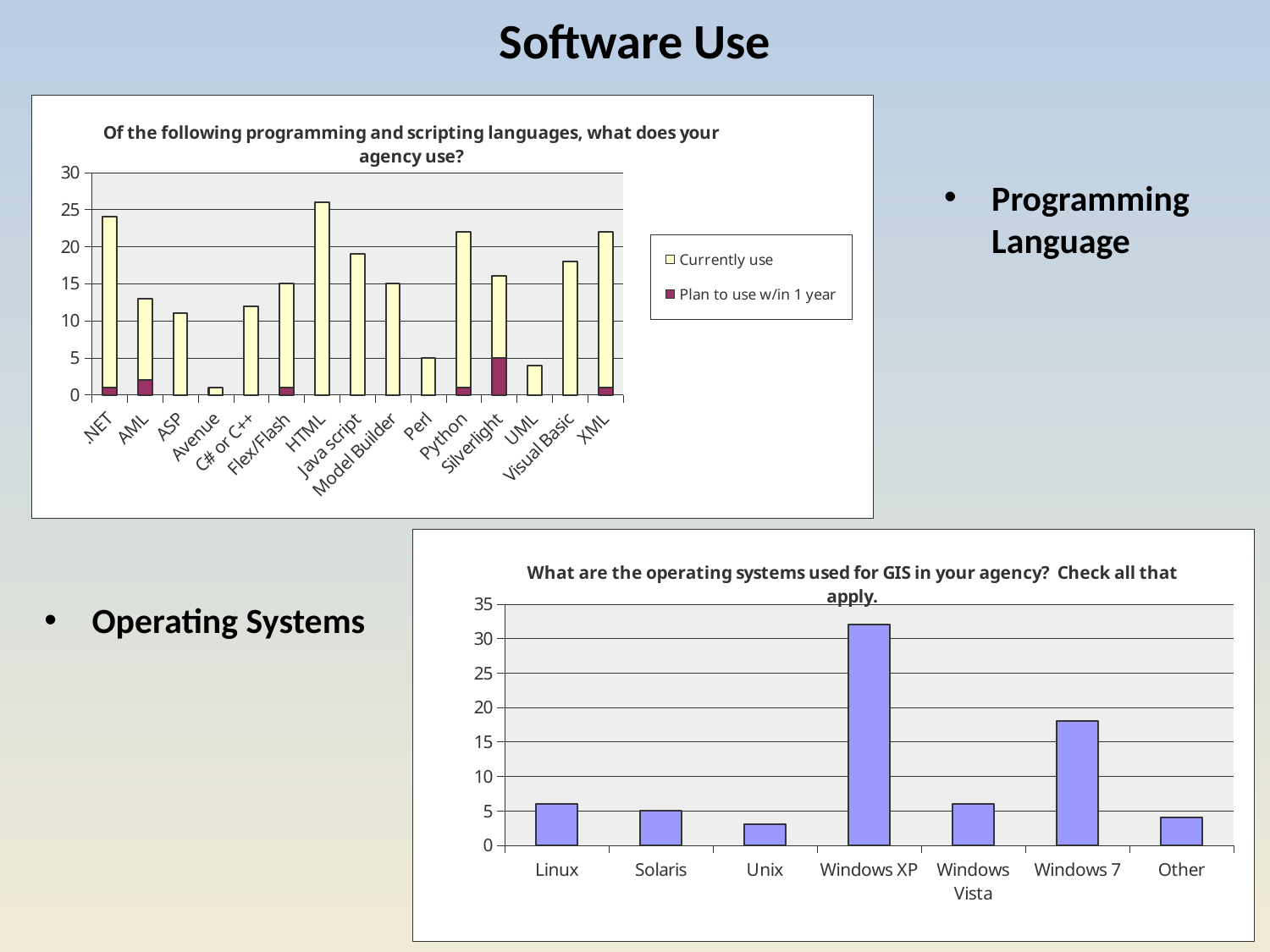
In the programming languages chart, how many languages are shown on the x axis? 15 In the chart titled "What are the operating systems used for GIS in your agency?", which operating system has the highest value? Windows XP What kind of chart is the operating systems chart? Bar chart In the operating systems chart, is the value for Windows 7 greater or less than 20? less In the operating systems chart, how many operating system categories are shown on the x axis? 7 In the chart titled "Of the following programming and scripting languages, what does your agency use?", which language has the tallest bar? HTML In the programming languages chart, which language has the shortest bar? Avenue In the chart titled "What are the operating systems used for GIS in your agency?", which operating system has the lowest value? Unix In the programming languages chart, how many series does the legend list? 2 In the programming languages chart, is the total bar for .NET greater or less than 20? greater In the operating systems chart, which is larger, the value for Windows XP or the value for Windows 7? Windows XP In the operating systems chart, is the value for Windows XP greater or less than 30? greater